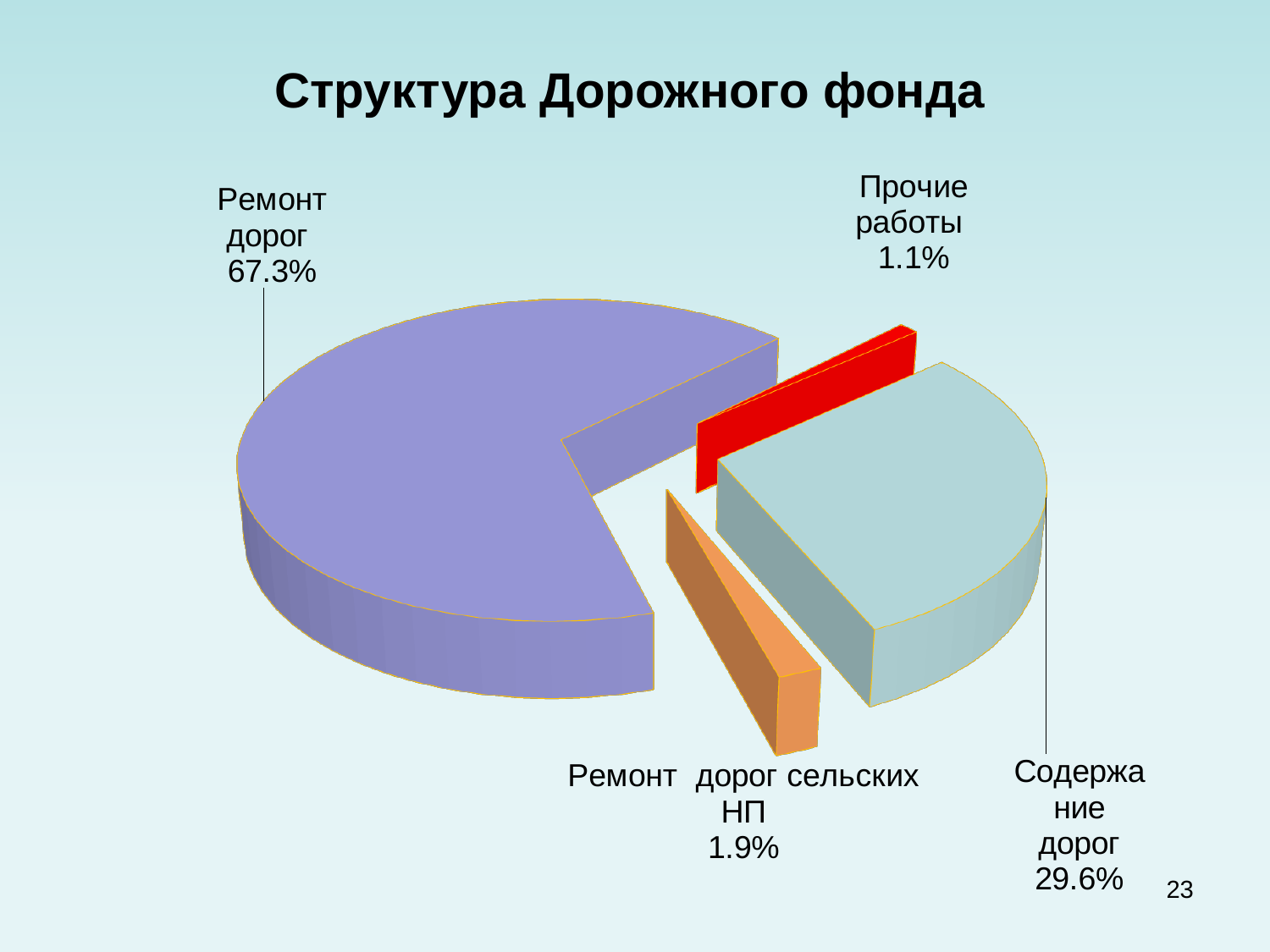
What is the title of the chart? Структура Дорожного фонда What share of the pie does Прочие работы have? 1.1% What share of the pie does Ремонт дорог сельских НП have? 1.9% What kind of chart is shown on the slide? Pie chart What share of the pie does Содержание дорог have? 29.6% What is the difference in percentage points between Ремонт дорог and Содержание дорог? 37.7 What colour is the Прочие работы slice? Red Which category has the smallest slice of the pie? Прочие работы How many slices does the pie chart have? 4 Which category has the largest slice of the pie? Ремонт дорог Which is larger, Ремонт дорог сельских НП or Прочие работы? Ремонт дорог сельских НП